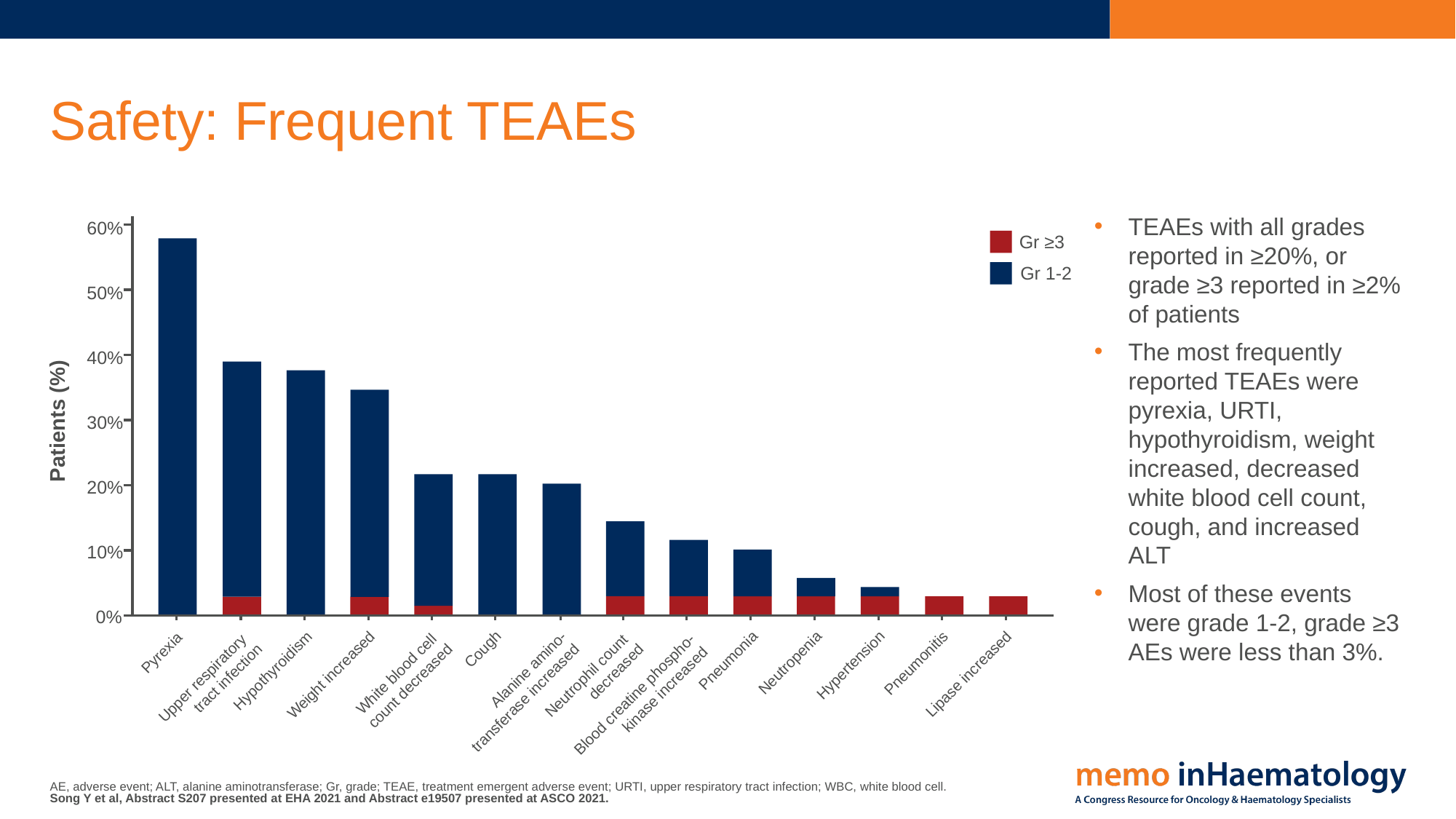
Which adverse event has the highest total percentage of patients? Pyrexia Is the total value for Hypothyroidism greater or less than 40%? less Do the total bar values rise or fall moving from left to right along the x axis? Fall Is the total value for Neutropenia greater or less than 10%? less Which has a higher total value, Neutrophil count decreased or Pneumonia? Neutrophil count decreased Which colour represents Gr ≥3 events in the legend? Red Is the total value for Weight increased greater or less than 30%? greater How many adverse event categories are plotted on the x axis? 13 Which has a higher total value, Pyrexia or Upper respiratory tract infection? Pyrexia How many series does the legend list? 2 What kind of chart is shown on the slide? Stacked bar chart